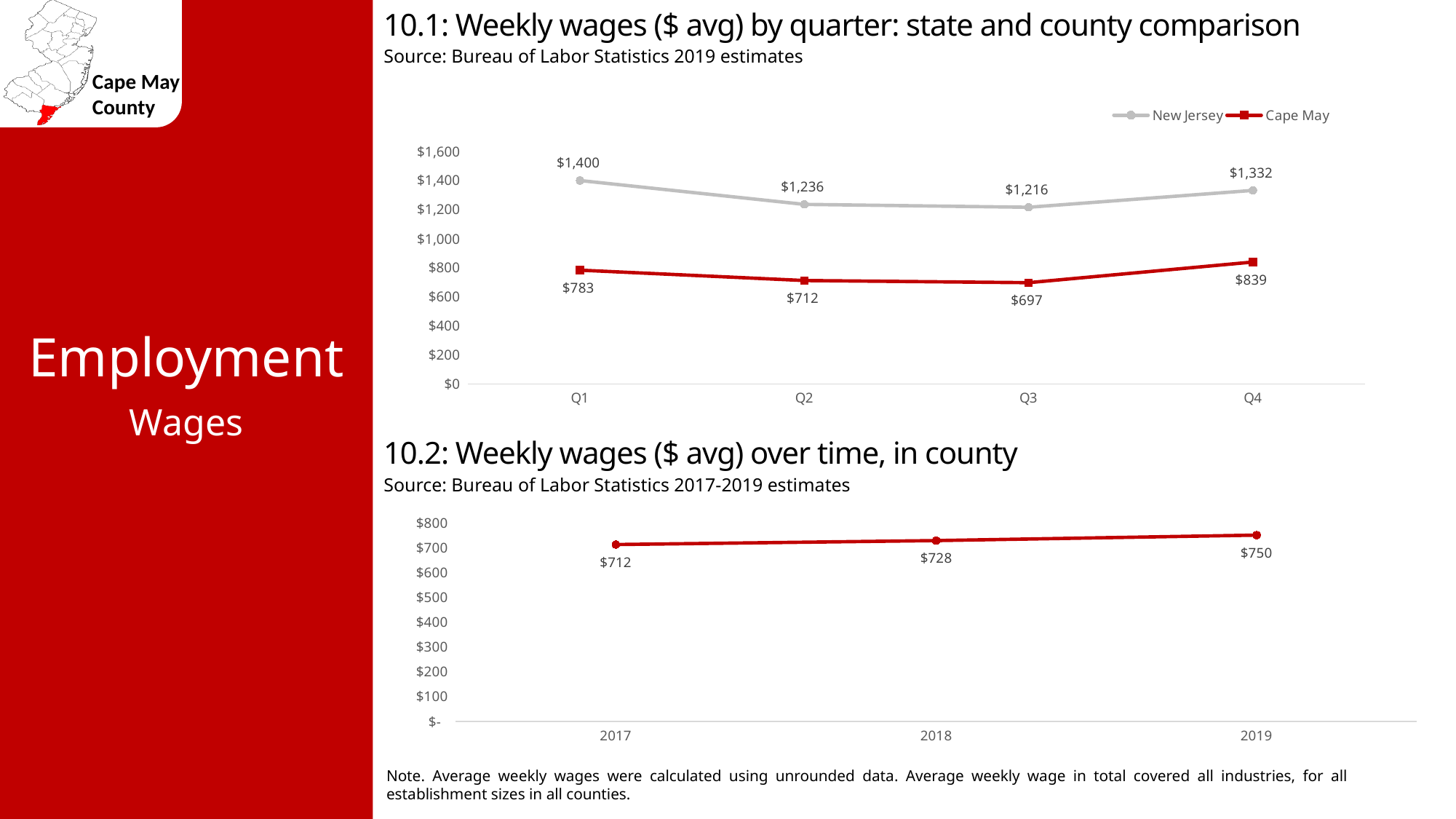
In chart 10.1, what is the Cape May average weekly wage in Q3? $697 In chart 10.2, do the weekly wages rise or fall from 2017 to 2019? Rise In chart 10.1, what is the difference between the New Jersey and Cape May weekly wages in Q4? $493 In chart 10.1, which series has the higher weekly wage in Q2, New Jersey or Cape May? New Jersey In chart 10.1, what is the New Jersey average weekly wage in Q1? $1,400 In chart 10.1, how many series does the legend list? 2 In chart 10.2, what is the difference between the 2019 and 2017 weekly wages? $38 In chart 10.2, how many years are plotted? 3 What type of chart is chart 10.1? Line chart In chart 10.1, which quarter has the lowest New Jersey weekly wage? Q3 In chart 10.1, which quarter has the highest Cape May weekly wage? Q4 In chart 10.2, what is the average weekly wage in 2018? $728